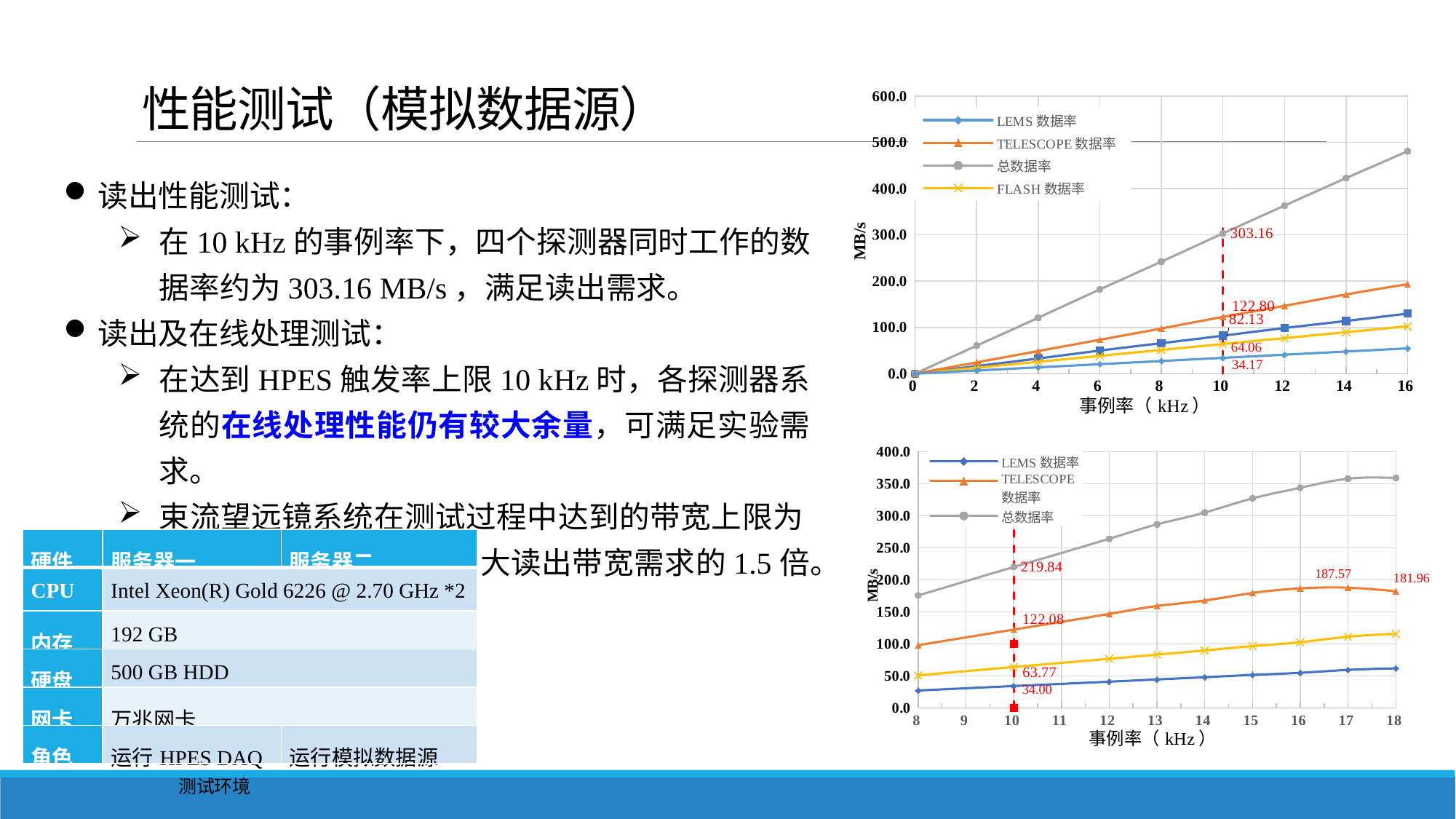
How many series does the legend of the top chart list? 4 In the top chart, what is the value of LEMS 数据率 at 10 kHz? 34.17 In the top chart, does 总数据率 rise or fall as the event rate increases? rises In the bottom chart, is the value of TELESCOPE 数据率 larger at 17 kHz or at 18 kHz? 17 kHz In the top chart, which series has the highest value at 16 kHz? 总数据率 In the bottom chart, is the value of 总数据率 at 16 kHz greater or less than 300? greater In the top chart, what is the value of TELESCOPE 数据率 at 10 kHz? 122.80 In the top chart, what is the value of 总数据率 at an event rate of 10 kHz? 303.16 In the bottom chart, what is the value of 总数据率 at 10 kHz? 219.84 In the bottom chart, what is the value of TELESCOPE 数据率 at 17 kHz? 187.57 In the top chart, what is the difference between 总数据率 and TELESCOPE 数据率 at 10 kHz? 180.36 What kind of chart is the top chart? line chart